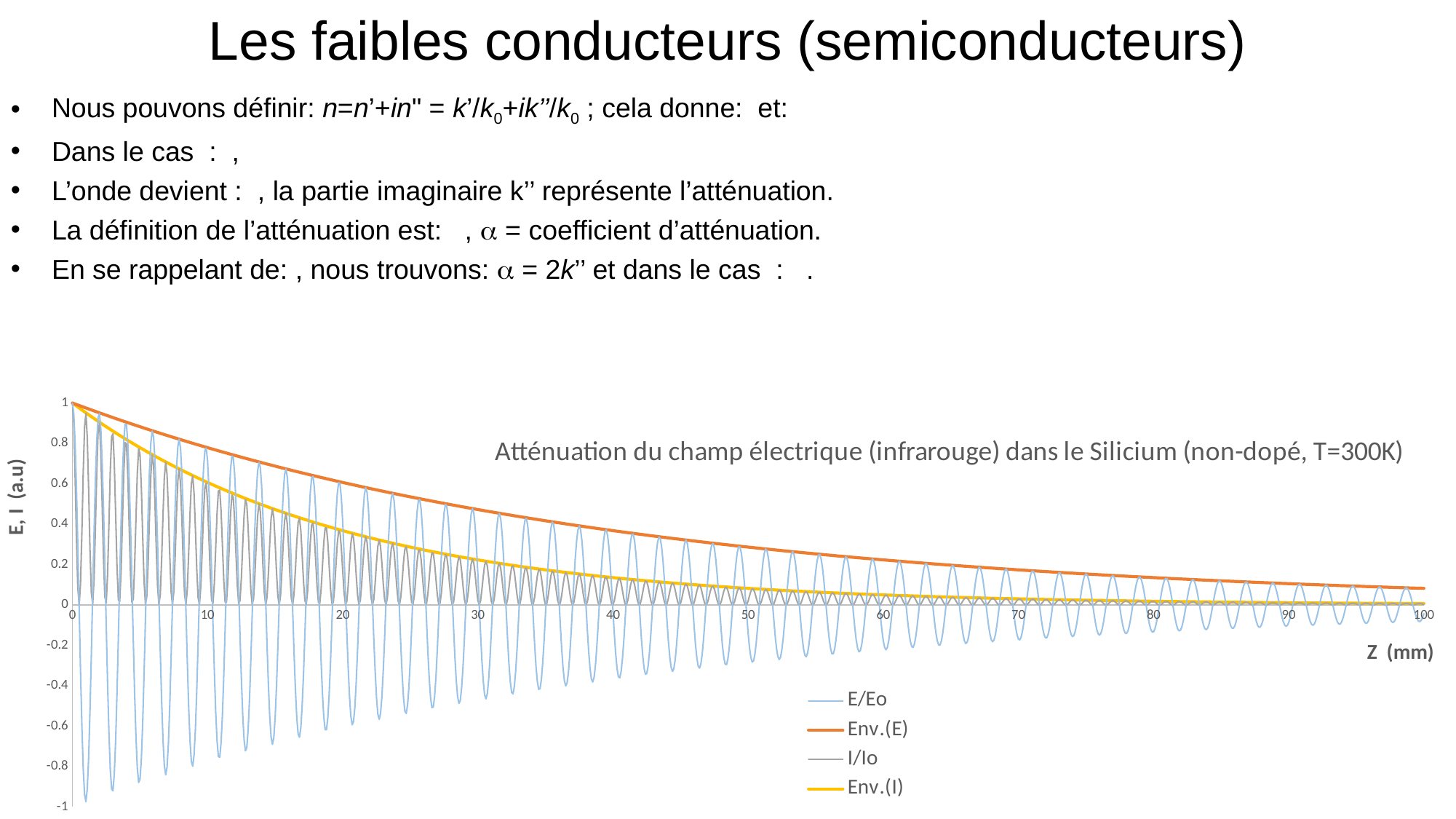
Is the value of Env.(E) at Z = 50 greater or less than 0.2? greater How many series does the chart legend list? 4 At Z = 50, which series has the larger value, Env.(E) or Env.(I)? Env.(E) Is the value of Env.(E) at Z = 100 greater or less than 0.2? less Is the value of Env.(I) at Z = 10 greater or less than 0.4? greater Does the Env.(E) series rise or fall as Z increases? fall What is the value of Env.(E) at Z = 0? 1 What is the label of the horizontal axis of the chart? Z (mm) Does the Env.(I) series rise or fall as Z increases? fall What is the title of the chart? Atténuation du champ électrique (infrarouge) dans le Silicium (non-dopé, T=300K) What kind of chart is shown on the slide? line chart